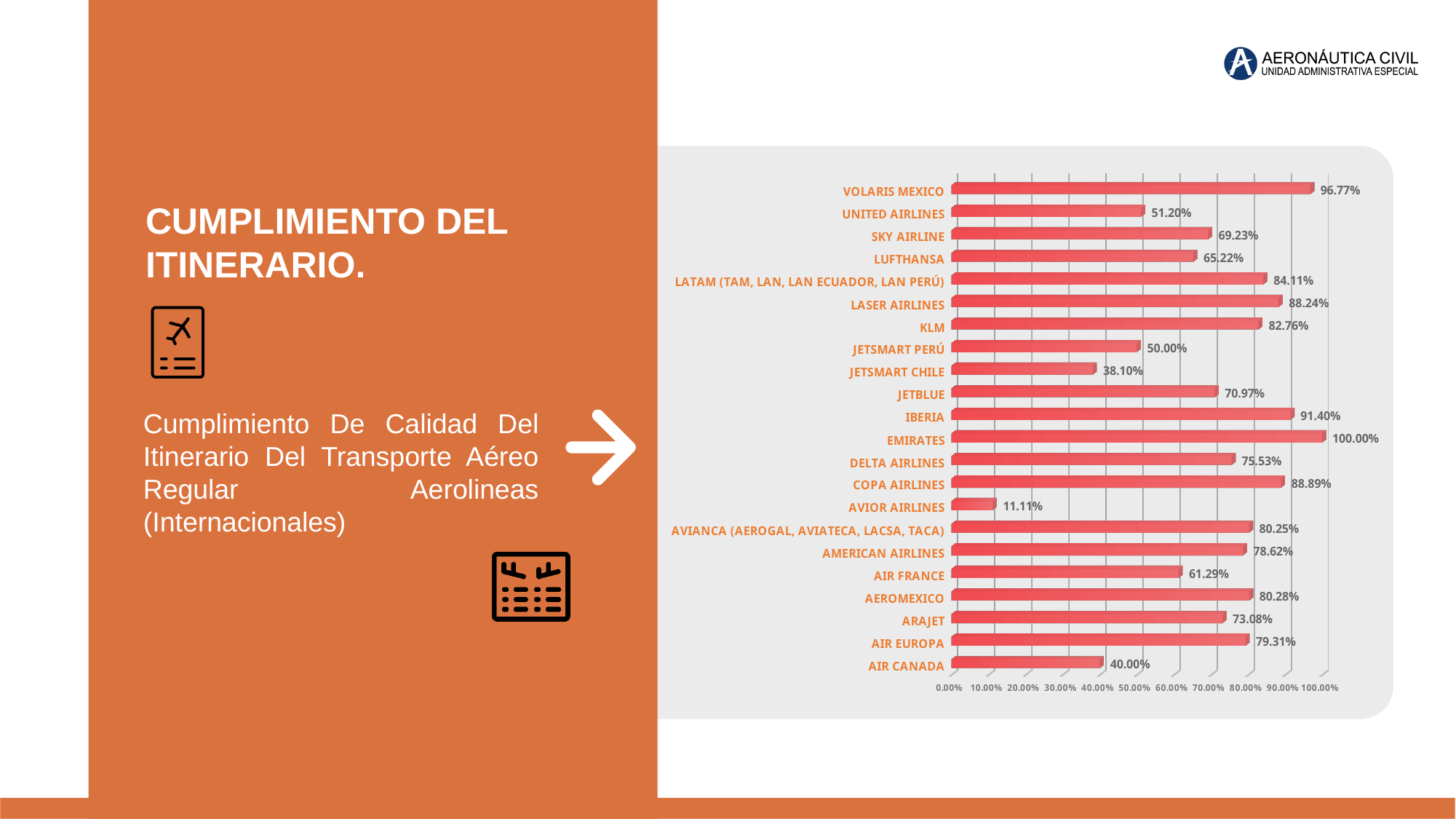
Which airline has the lowest value? AVIOR AIRLINES What kind of chart is shown on the slide? bar chart How many airlines are shown in the chart? 22 Is the value for LUFTHANSA greater or less than 60.00%? greater What is the difference between the values for VOLARIS MEXICO and UNITED AIRLINES? 45.57% Which airline has the highest value? EMIRATES What is the value for AVIANCA (AEROGAL, AVIATECA, LACSA, TACA)? 80.25% What is the value for EMIRATES? 100.00% Which is larger, the value for KLM or the value for AIR FRANCE? KLM What is the value for AIR CANADA? 40.00% What is the difference between the values for IBERIA and JETBLUE? 20.43% What is the value for JETSMART CHILE? 38.10%